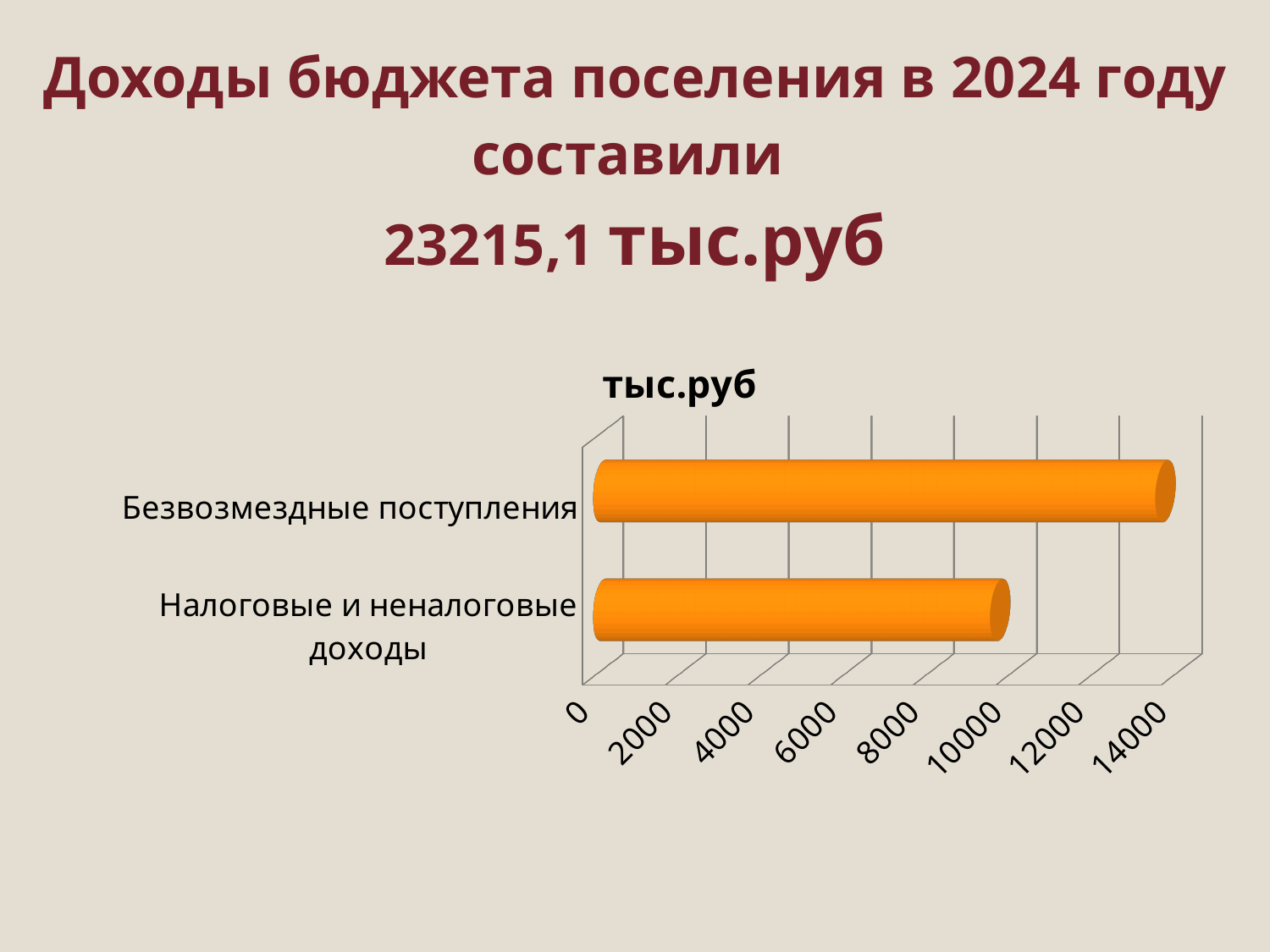
Which is larger: the value for Безвозмездные поступления or the value for Налоговые и неналоговые доходы? Безвозмездные поступления How many categories are plotted in the chart? 2 Which category has the lowest value in the chart? Налоговые и неналоговые доходы Which category has the highest value in the chart? Безвозмездные поступления What kind of chart is shown on the slide? bar chart Is the value for Налоговые и неналоговые доходы greater or less than 8000? greater What is the highest tick value shown on the value axis of the chart? 14000 Is the value for Безвозмездные поступления greater or less than 10000? greater Is the value for Безвозмездные поступления greater or less than 12000? greater What is the title of the chart? тыс.руб